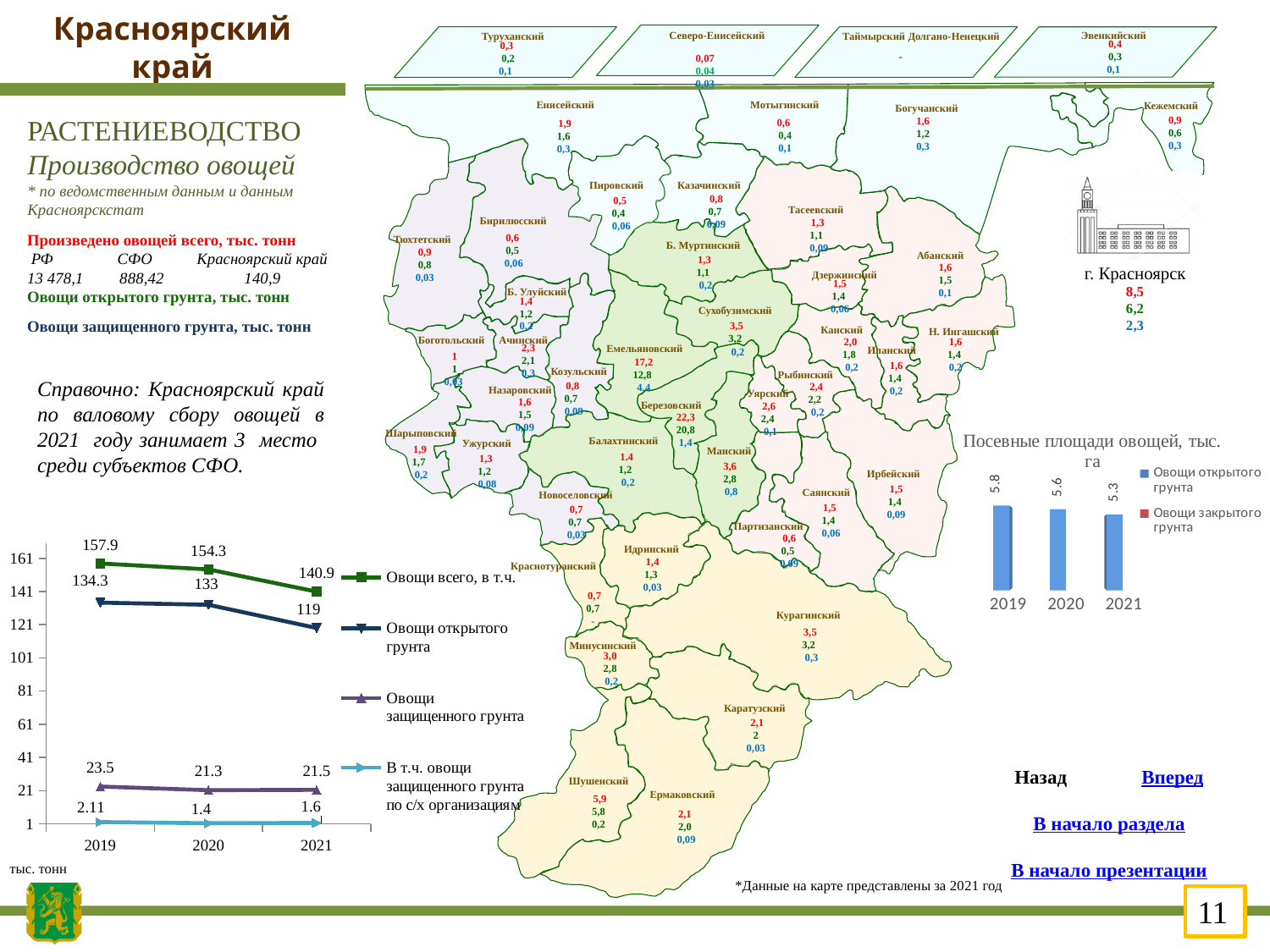
In the line chart at the bottom left, what is the value of 'Овощи всего' in 2019? 157.9 In the bar chart 'Посевные площади овощей, тыс. га', what is the value for 2021? 5.3 In the line chart at the bottom left, by how much did 'Овощи всего' decrease from 2019 to 2021? 17 In the line chart at the bottom left, how many series does the legend list? 4 In the line chart at the bottom left, what is the value of 'Овощи защищенного грунта' in 2020? 21.3 In the line chart at the bottom left, which year has the lowest value for 'Овощи открытого грунта'? 2021 In the line chart at the bottom left, what is the value of 'Овощи открытого грунта' in 2021? 119 In the line chart at the bottom left, what is the 2019 value for 'В т.ч. овощи защищенного грунта по с/х организациям'? 2.11 In the bar chart 'Посевные площади овощей, тыс. га', which year has the highest value? 2019 In the line chart at the bottom left, does 'Овощи всего' rise or fall from 2019 to 2021? fall What type of chart is 'Посевные площади овощей, тыс. га'? bar chart In the bar chart 'Посевные площади овощей, тыс. га', what is the value for 2019? 5.8